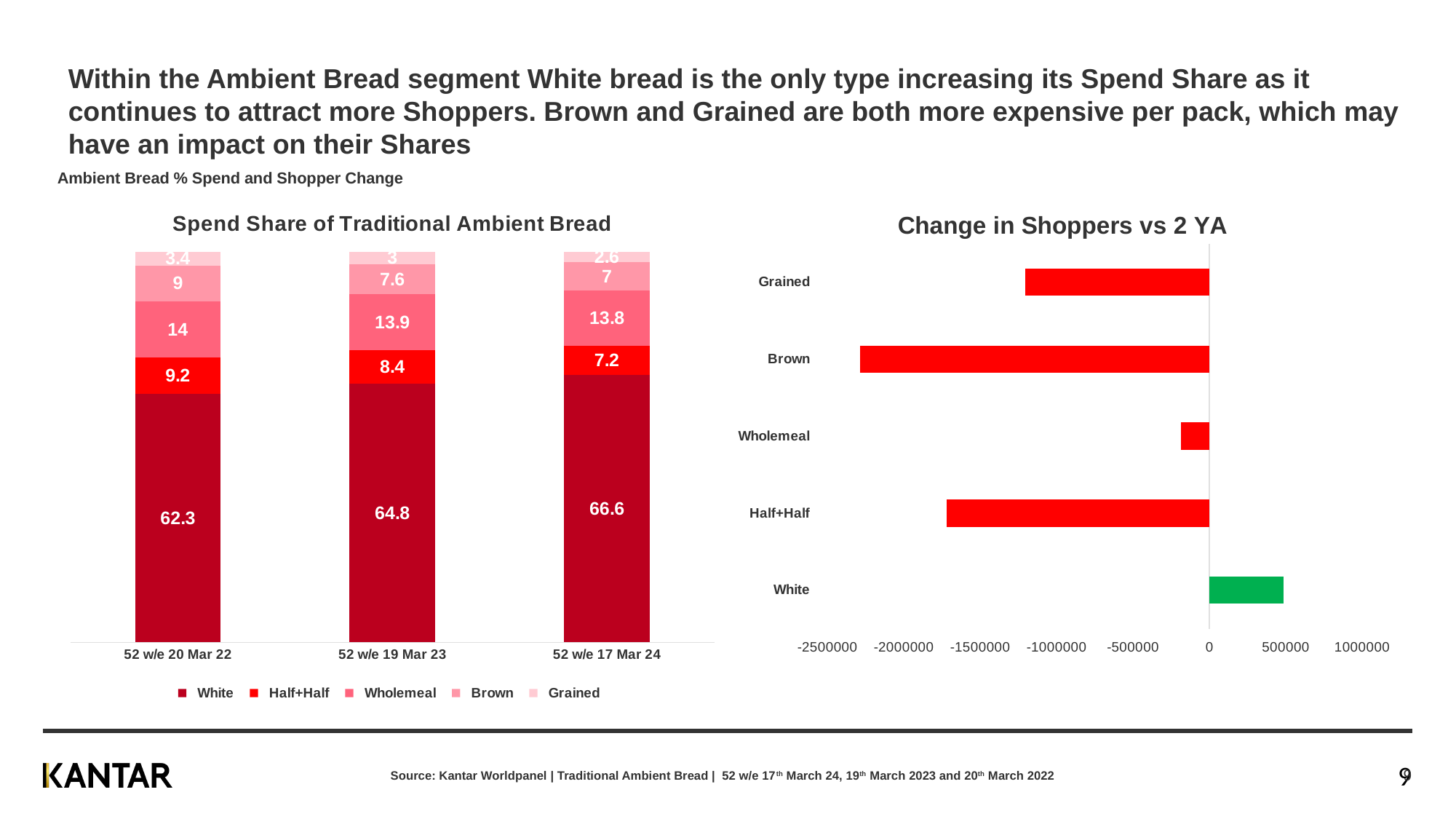
In the Spend Share of Traditional Ambient Bread chart, what is the total of the stacked bar for 52 w/e 19 Mar 23? 97.7 In the Spend Share of Traditional Ambient Bread chart, what is the spend share of Brown bread in 52 w/e 20 Mar 22? 9 In the Change in Shoppers vs 2 YA chart, which bread type is the only one with a positive change in shoppers? White What kind of chart is the Change in Shoppers vs 2 YA chart? bar chart In the Change in Shoppers vs 2 YA chart, is the value for Brown greater or less than -2000000? less In the Spend Share of Traditional Ambient Bread chart, does the Half+Half spend share rise or fall across the three periods? fall In the Change in Shoppers vs 2 YA chart, which bread type has the largest decline in shoppers? Brown In the Spend Share of Traditional Ambient Bread chart, by how much did the White bread spend share change from 52 w/e 20 Mar 22 to 52 w/e 17 Mar 24? 4.3 In the Spend Share of Traditional Ambient Bread chart, what is the spend share of Half+Half in 52 w/e 19 Mar 23? 8.4 In the Spend Share of Traditional Ambient Bread chart, which is larger in 52 w/e 17 Mar 24: the Wholemeal share or the Brown share? Wholemeal In the Spend Share of Traditional Ambient Bread chart, what is the spend share of White bread in 52 w/e 17 Mar 24? 66.6 How many series does the legend of the Spend Share of Traditional Ambient Bread chart list? 5